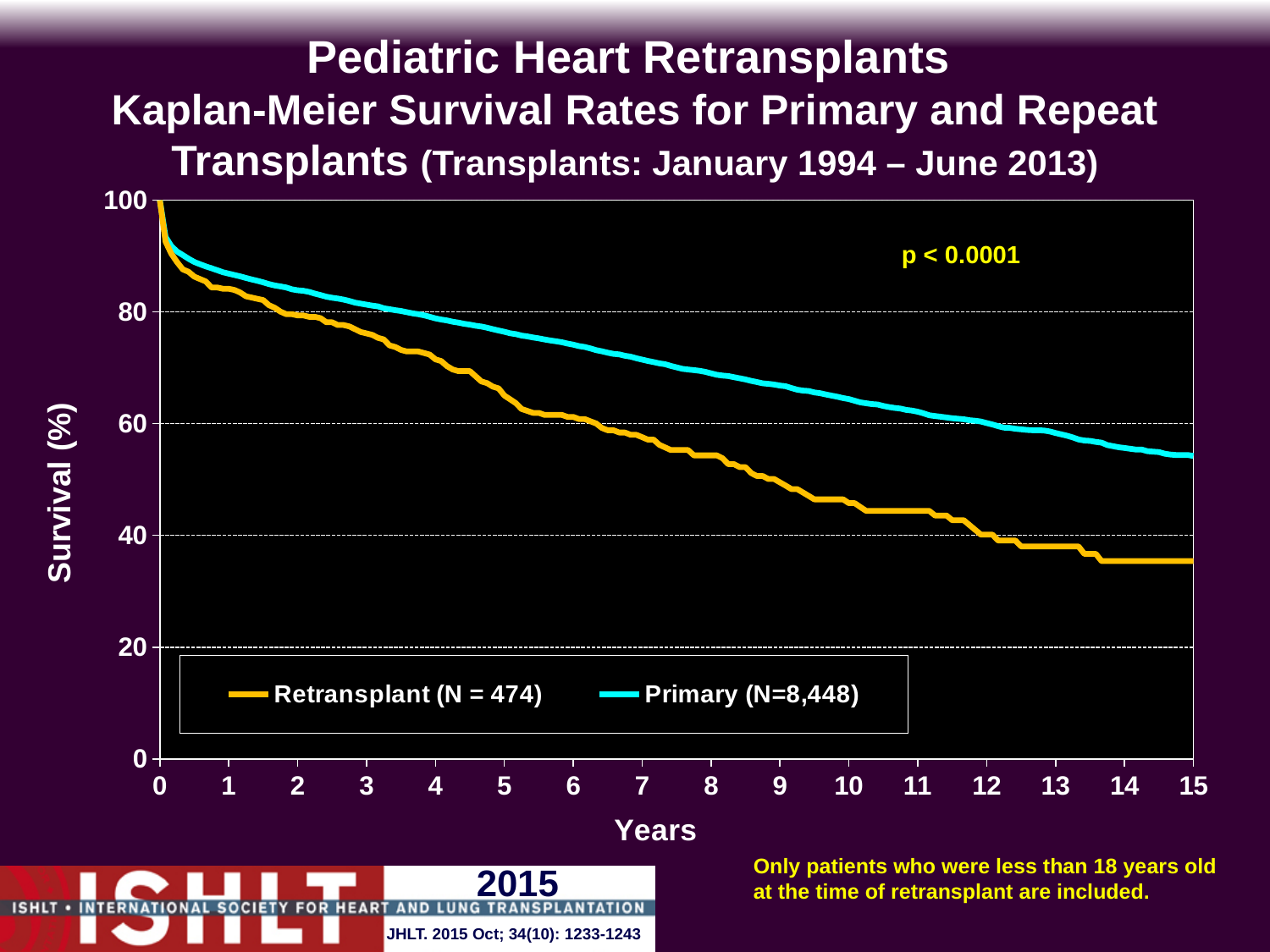
Is the survival value for the Primary series at 15 years greater or less than 40? greater At 10 years, which series has the higher survival, Primary or Retransplant? Primary Is the survival value for the Primary series at 1 year greater or less than 80? greater Do the survival values for the Primary series rise or fall as years increase? fall Which series is plotted in yellow/orange? Retransplant (N = 474) What is the N for the Primary series shown in the legend? 8,448 Is the survival value for the Retransplant series at 10 years greater or less than 60? less How many series does the legend list? 2 What kind of chart is shown on the slide? line chart Do the survival values for the Retransplant series rise or fall as years increase? fall